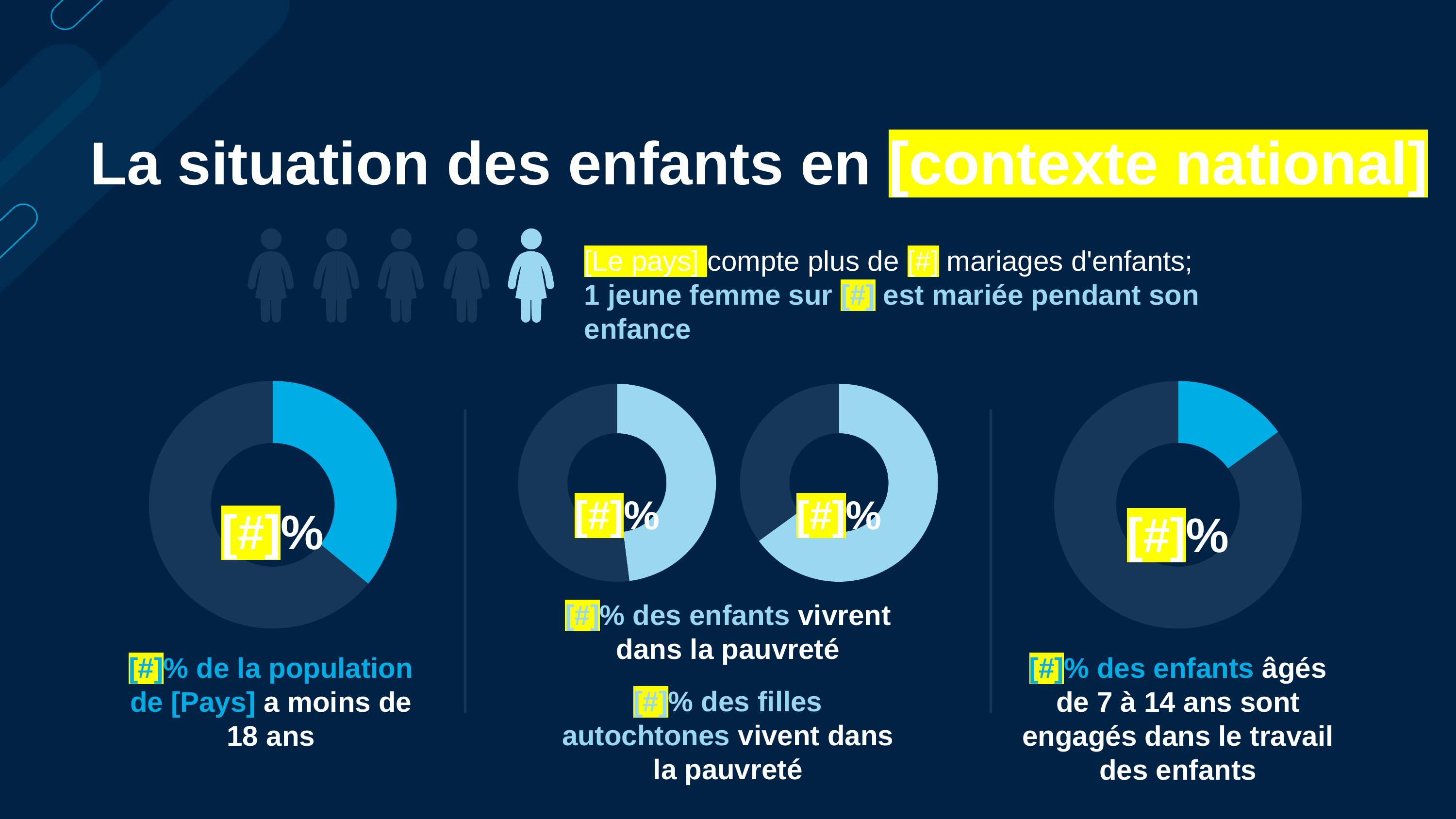
Is the highlighted slice of the leftmost donut chart larger or smaller than the highlighted slice of the rightmost donut chart? Larger What placeholder text is printed in the centre of each donut chart? [#]% In the row of person icons at the top of the slide, how many icons are shown in total? 5 Is the highlighted slice of the middle-right donut chart greater or less than half of the ring? Greater Which donut chart has the smallest highlighted slice: the leftmost one, one of the two middle ones, or the rightmost one? The rightmost one In the row of person icons at the top of the slide, how many icons are highlighted in light blue? 1 How many donut charts are shown on the slide? 4 Is the highlighted slice of the rightmost donut chart greater or less than half of the ring? Less What does the caption under the leftmost donut chart describe? [#]% de la population de [Pays] a moins de 18 ans What kind of chart is used for the four circular graphics on the slide? Donut (pie) chart